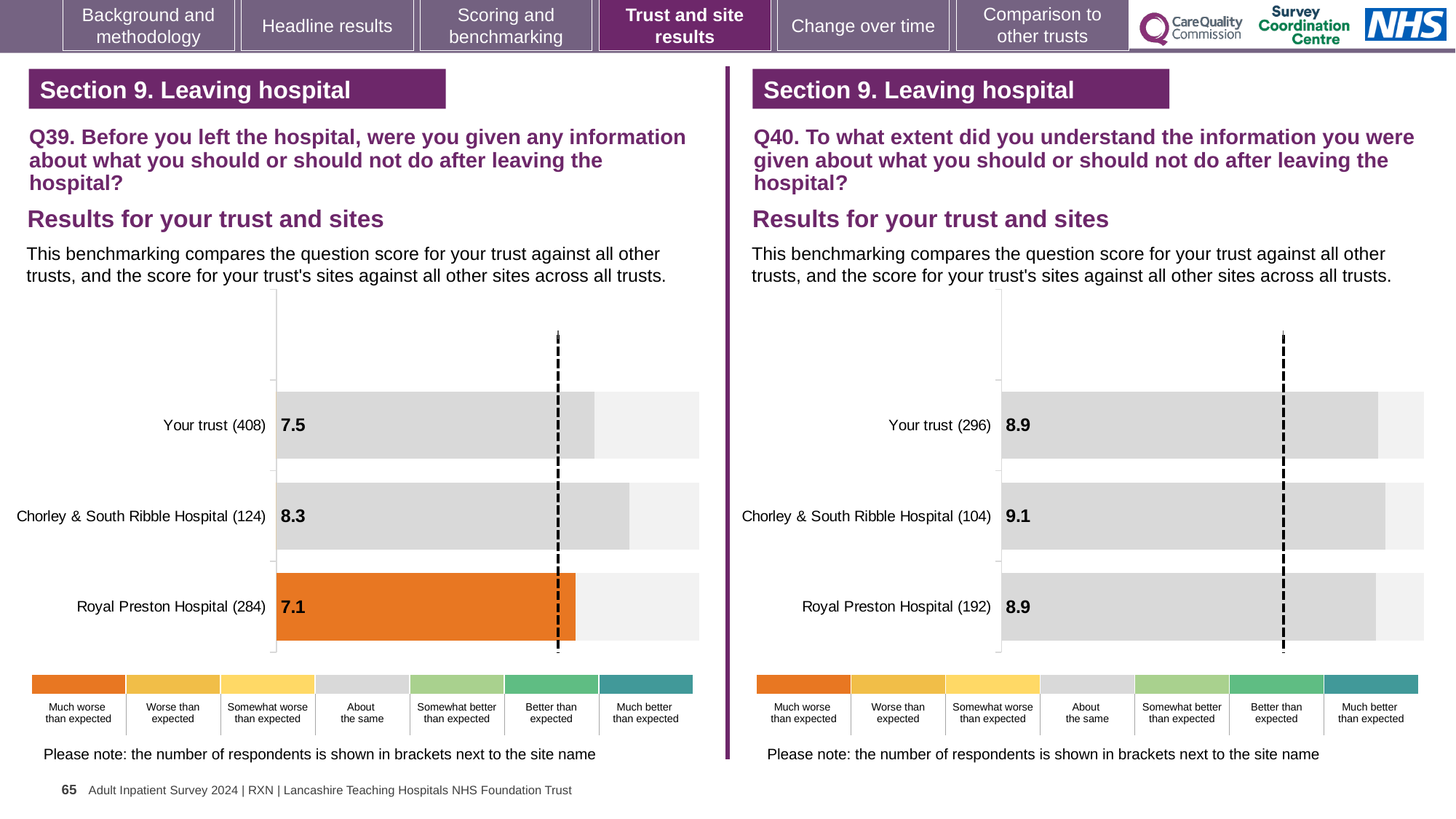
In the Q40 chart on the right, what is the score for Chorley & South Ribble Hospital? 9.1 How many bars are plotted in the Q39 chart on the left? 3 In the Q39 chart on the left, which bar is coloured orange, indicating 'Much worse than expected'? Royal Preston Hospital In the Q40 chart on the right, which site or trust has the highest score? Chorley & South Ribble Hospital In the Q39 chart on the left, what is the difference between the scores for Chorley & South Ribble Hospital and Royal Preston Hospital? 1.2 In the Q39 chart on the left, which site or trust has the highest score? Chorley & South Ribble Hospital In the Q39 chart on the left, what is the score for Royal Preston Hospital? 7.1 In the Q39 chart on the left, what is the score for Chorley & South Ribble Hospital? 8.3 In the Q39 chart on the left, which site or trust has the lowest score? Royal Preston Hospital In the Q40 chart on the right, what is the score for Royal Preston Hospital? 8.9 In the Q40 chart on the right, what is the difference between the scores for Chorley & South Ribble Hospital and Your trust? 0.2 In the Q39 chart on the left, what is the score for Your trust? 7.5